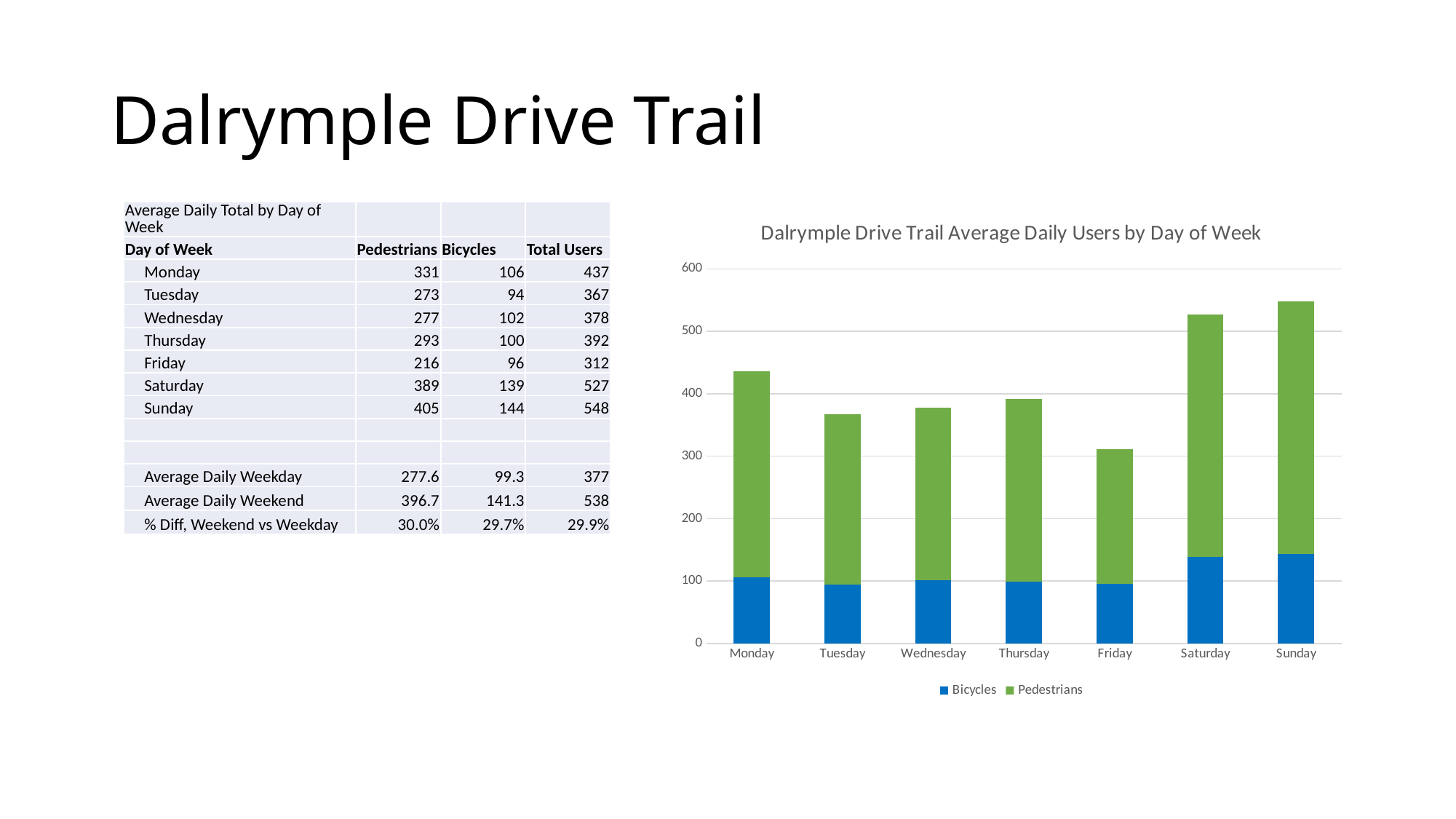
Which day has the highest total bar in the chart? Sunday Is the Bicycles segment for Tuesday greater or less than 100? less Which day has the lowest total bar in the chart? Friday What is the title of the chart? Dalrymple Drive Trail Average Daily Users by Day of Week Is the total bar for Monday greater or less than 400? greater Which is larger, the total bar for Wednesday or the total bar for Friday? Wednesday Is the total bar for Saturday greater or less than 500? greater Which colour represents Pedestrians in the chart? green What is the total number of average daily users for Sunday, as shown in the table? 548 How many series does the chart legend list? 2 What kind of chart is shown on the slide? stacked bar chart How many days of the week are plotted on the x axis of the chart? 7